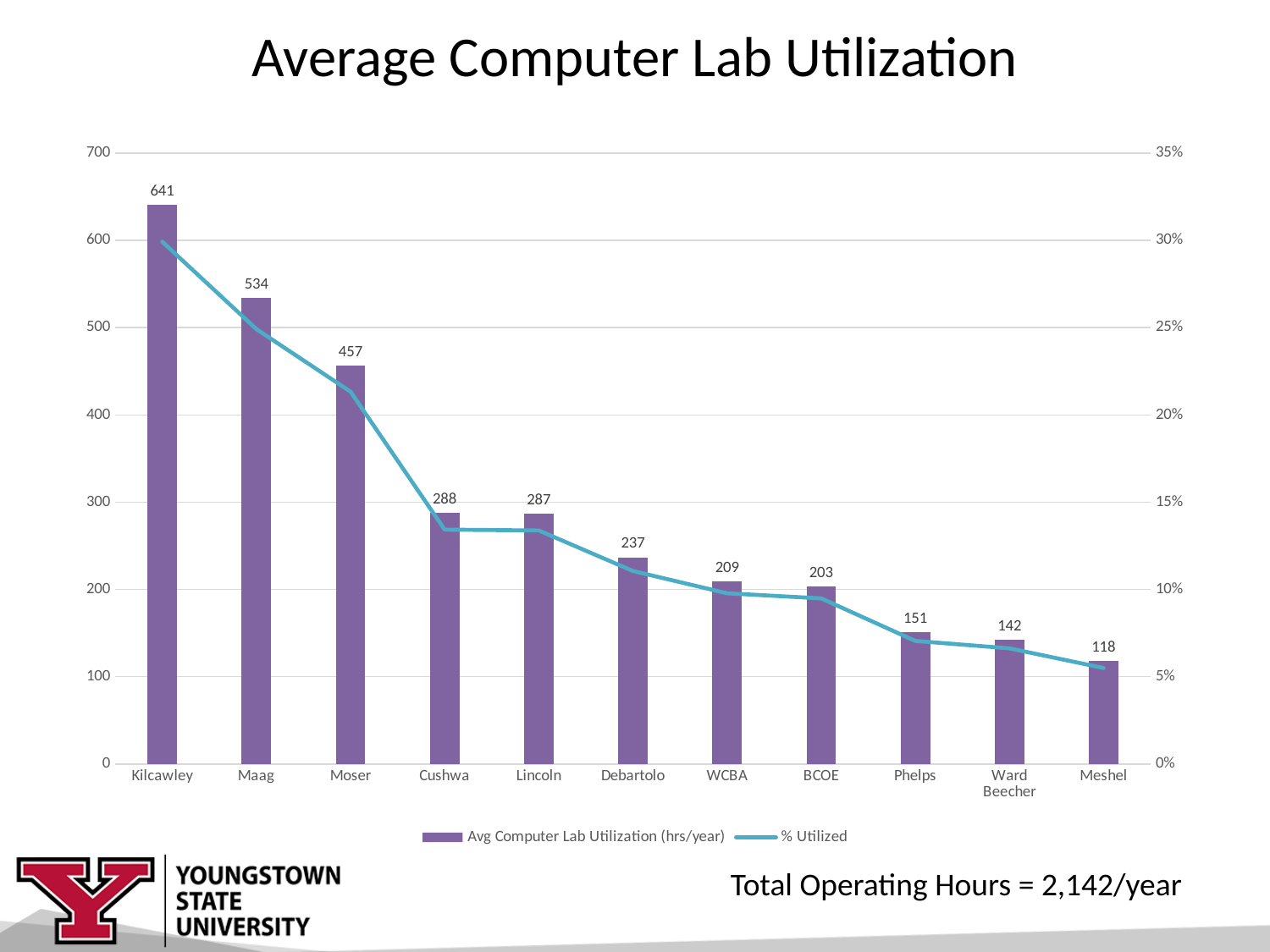
Do the average utilization hours rise or fall from left to right across the labs? fall Which lab has the highest average computer lab utilization? Kilcawley Is the % Utilized value for Meshel greater or less than 10%? less What is the average computer lab utilization (hrs/year) for Ward Beecher? 142 What is the average computer lab utilization (hrs/year) for Debartolo? 237 Is the % Utilized value for Kilcawley greater or less than 25%? greater What is the difference in average utilization hours between Kilcawley and Maag? 107 Which lab has the lowest average computer lab utilization? Meshel What is the average computer lab utilization (hrs/year) for Kilcawley? 641 Which has a higher average computer lab utilization, Moser or WCBA? Moser How many series does the legend list? 2 How many labs are shown on the x axis? 11